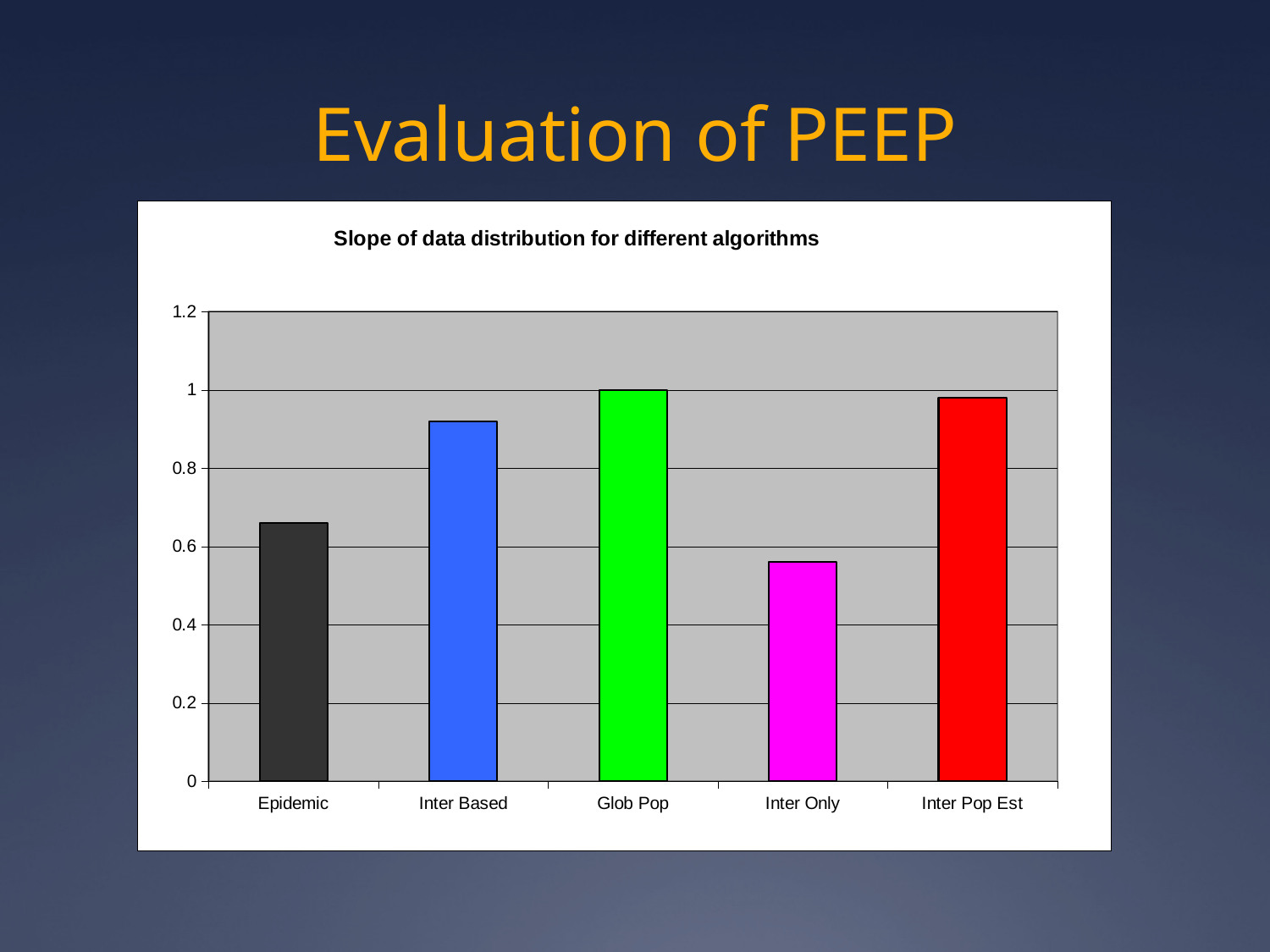
Which is larger, the value for Epidemic or the value for Inter Based? Inter Based What is the title of the chart? Slope of data distribution for different algorithms Is the value for Inter Pop Est greater or less than 0.8? greater Is the value for Inter Based greater or less than 0.8? greater What colour is the bar for Glob Pop? green What kind of chart is shown on the slide? bar chart Which is larger, the value for Inter Only or the value for Inter Pop Est? Inter Pop Est Which algorithm has the lowest slope value? Inter Only How many algorithms (categories) are shown on the x axis? 5 What is the value for Glob Pop? 1 Is the value for Inter Only greater or less than 0.6? less